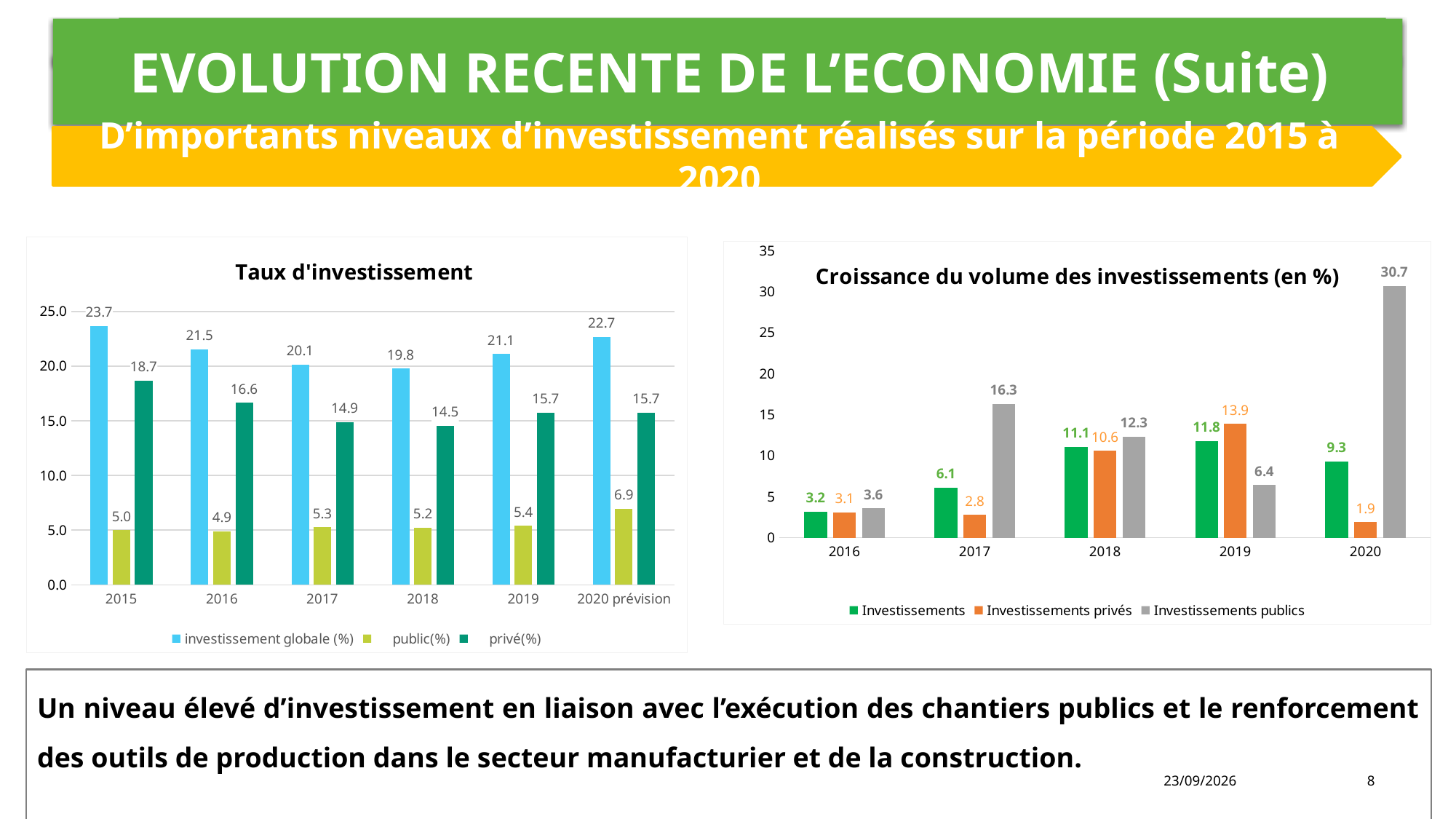
In the 'Croissance du volume des investissements (en %)' chart, what is the difference between Investissements publics and Investissements privés in 2017? 13.5 In the 'Taux d'investissement' chart, how many series does the legend list? 3 In the 'Croissance du volume des investissements (en %)' chart, which year has the highest Investissements publics value? 2020 In the 'Taux d'investissement' chart, what is the difference between investissement globale (%) and privé(%) in 2016? 4.9 In the 'Croissance du volume des investissements (en %)' chart, what is the value of Investissements publics for 2020? 30.7 In the 'Croissance du volume des investissements (en %)' chart, what is the value of Investissements privés for 2019? 13.9 In the 'Croissance du volume des investissements (en %)' chart, which is larger in 2018: Investissements or Investissements privés? Investissements In the 'Taux d'investissement' chart, how many categories are shown on the x axis? 6 In the 'Taux d'investissement' chart, what is the value of investissement globale (%) for 2015? 23.7 What kind of chart is the 'Croissance du volume des investissements (en %)' chart? Bar chart In the 'Taux d'investissement' chart, what is the value of public(%) for 2020 prévision? 6.9 In the 'Taux d'investissement' chart, which year has the lowest investissement globale (%) value? 2018